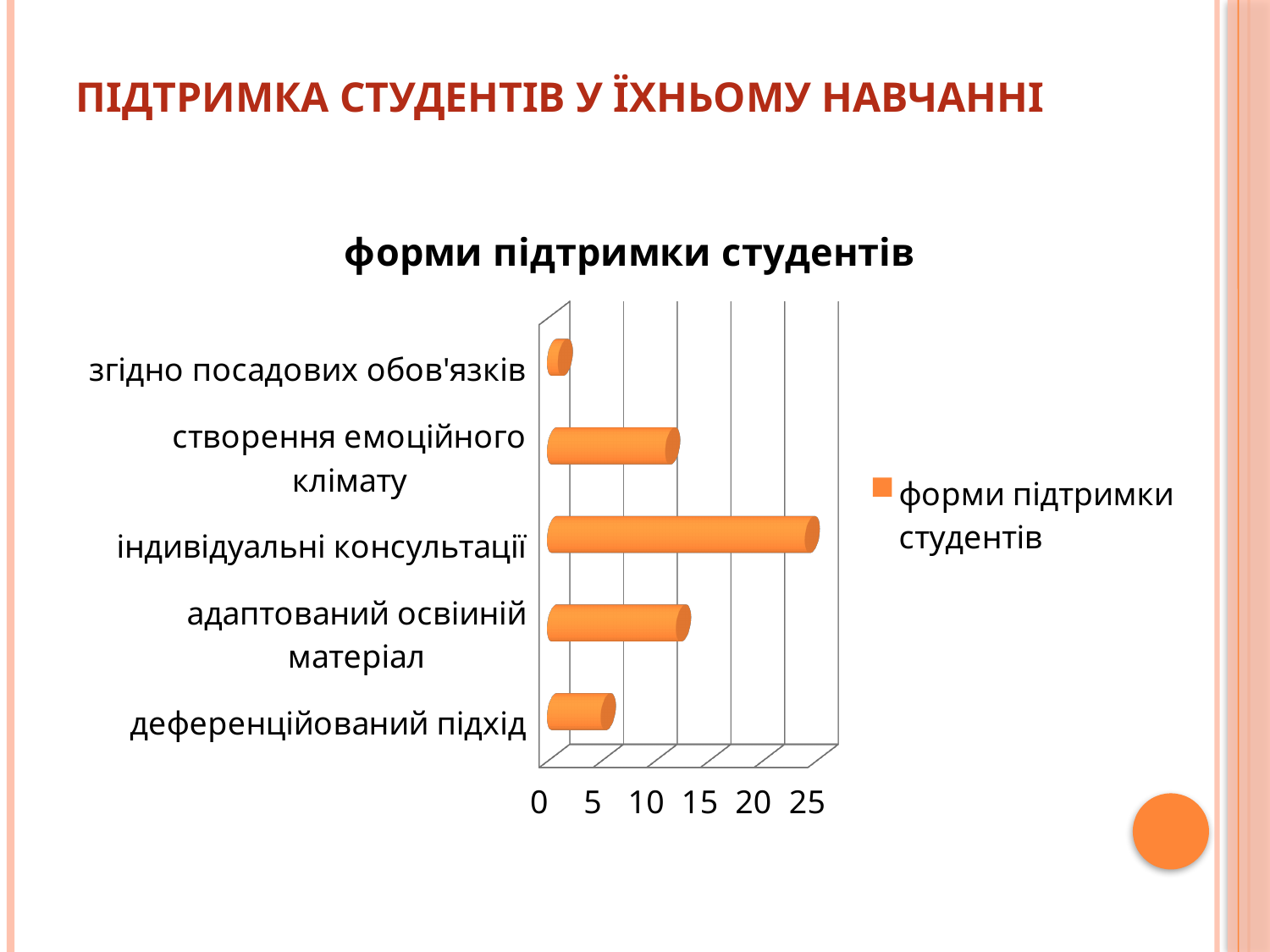
What kind of chart is shown on the slide? bar chart What is the title of the chart? форми підтримки студентів Is the value for індивідуальні консультації greater or less than 20? greater Is the value for згідно посадових обов'язків greater or less than 5? less Which is larger: the value for створення емоційного клімату or the value for згідно посадових обов'язків? створення емоційного клімату How many series does the legend list? 1 Which category has the highest value? індивідуальні консультації Which is larger: the value for індивідуальні консультації or the value for деференційований підхід? індивідуальні консультації How many categories are plotted in the chart? 5 Is the value for деференційований підхід greater or less than 10? less Which category has the lowest value? згідно посадових обов'язків